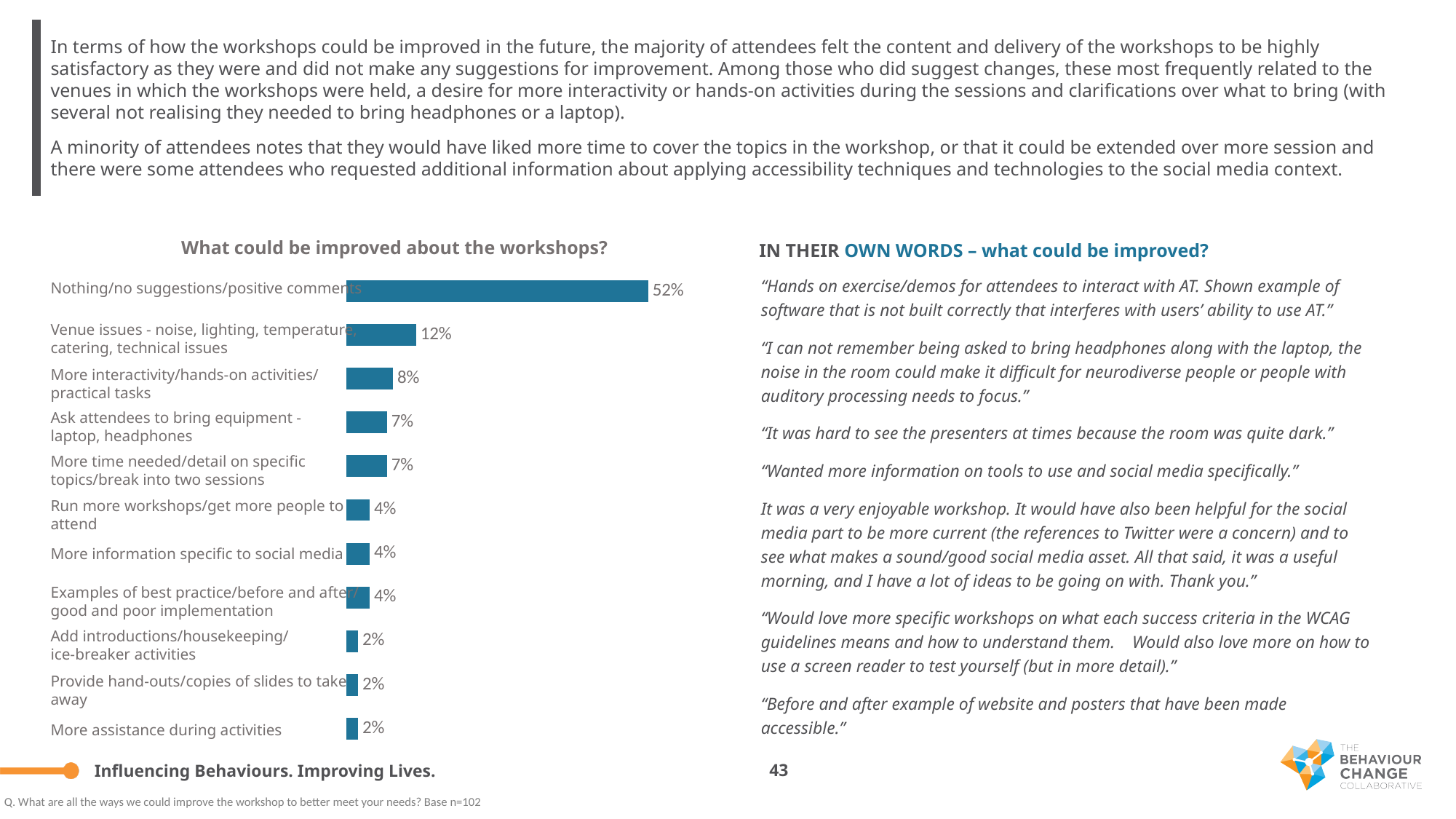
Which category has the highest value in the chart? Nothing/no suggestions/positive comments What is the value for 'Ask attendees to bring equipment - laptop, headphones'? 7% What percentage of attendees gave 'Nothing/no suggestions/positive comments'? 52% What is the value for 'Venue issues - noise, lighting, temperature, catering, technical issues'? 12% What type of chart is used on the slide? Bar chart Which is larger: 'More interactivity/hands-on activities/practical tasks' or 'Run more workshops/get more people to attend'? More interactivity/hands-on activities/practical tasks What is the value for 'More assistance during activities'? 2% What percentage is shown for 'More interactivity/hands-on activities/practical tasks'? 8% What is the difference between 'Nothing/no suggestions/positive comments' and 'Venue issues - noise, lighting, temperature, catering, technical issues'? 40 percentage points What is the difference between 'Venue issues - noise, lighting, temperature, catering, technical issues' and 'More interactivity/hands-on activities/practical tasks'? 4 percentage points How many categories are shown in the chart? 11 What is the title of the chart? What could be improved about the workshops?